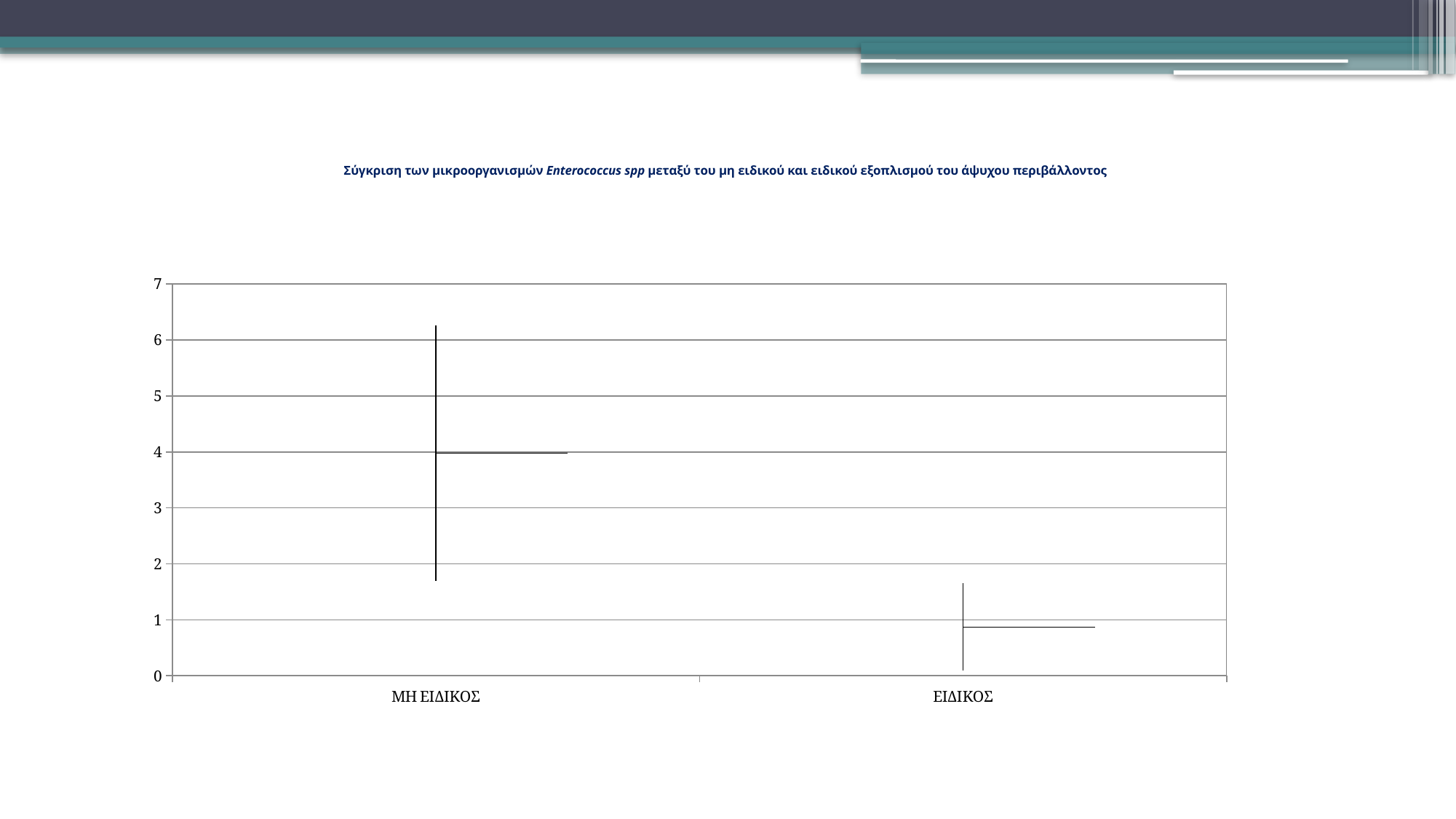
Do the values rise or fall from ΜΗ ΕΙΔΙΚΟΣ to ΕΙΔΙΚΟΣ along the x axis? fall Is the upper end of the vertical line for ΜΗ ΕΙΔΙΚΟΣ greater or less than 6? greater Is the value for ΜΗ ΕΙΔΙΚΟΣ larger or smaller than the value for ΕΙΔΙΚΟΣ? larger Is the value for ΕΙΔΙΚΟΣ greater or less than 2? less Which microorganism is named in the chart title? Enterococcus spp What is the highest value shown on the y axis of the chart? 7 Which category has the lower value in the chart? ΕΙΔΙΚΟΣ Which category has the higher value in the chart? ΜΗ ΕΙΔΙΚΟΣ Is the value for ΜΗ ΕΙΔΙΚΟΣ greater or less than 3? greater How many categories are shown on the x axis of the chart? 2